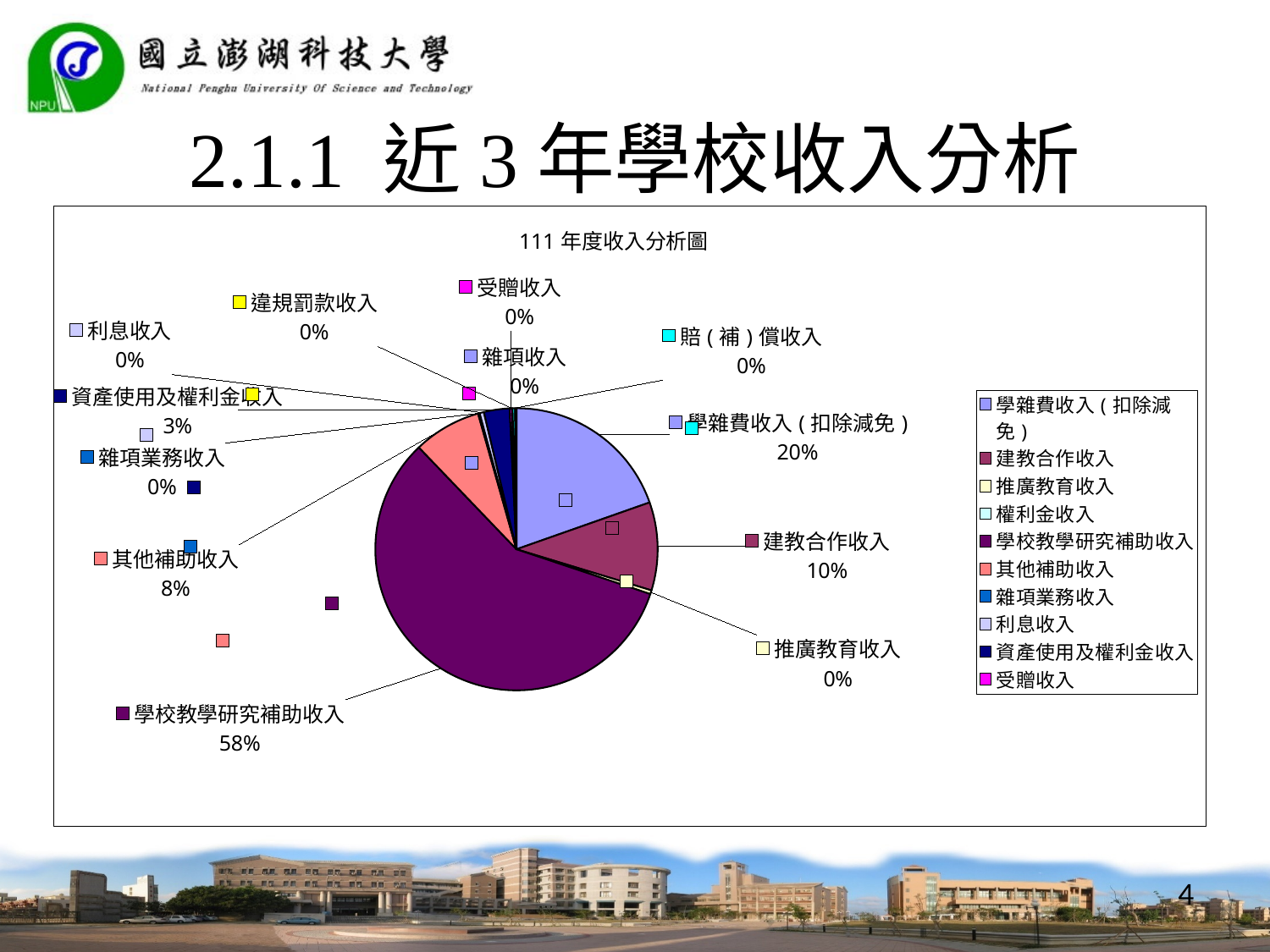
What percentage is shown for 學雜費收入(扣除減免)? 20% What kind of chart is shown on the slide? pie chart What is the difference in percentage points between 學雜費收入(扣除減免) and 建教合作收入? 10 Which category has the largest share of the pie? 學校教學研究補助收入 What percentage is shown for 資產使用及權利金收入? 3% How many entries does the legend list? 10 What percentage is shown for 推廣教育收入? 0% What share of the pie does 學校教學研究補助收入 account for? 58% What percentage is shown for 其他補助收入? 8% What percentage is shown for 建教合作收入? 10% What is the title of the chart? 111 年度收入分析圖 Which is larger, the share for 其他補助收入 or the share for 資產使用及權利金收入? 其他補助收入